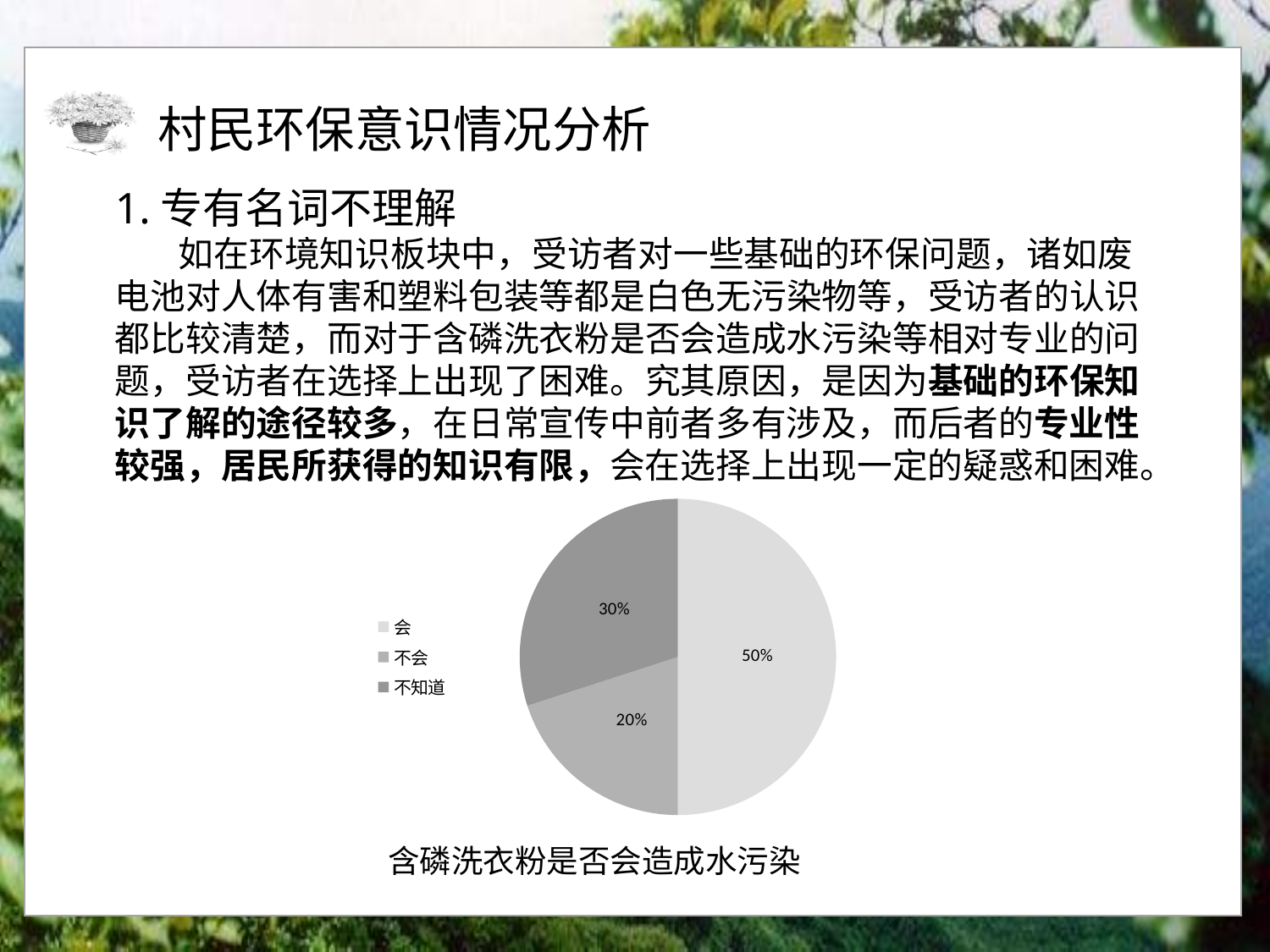
Which category has the smallest slice of the pie? 不会 How many slices does the pie chart have? 3 What share of the pie does 不会 take? 20% What kind of chart is shown on the slide? pie chart How many entries does the legend list? 3 What share of the pie does 会 take? 50% What is the caption shown below the pie chart? 含磷洗衣粉是否会造成水污染 What is the difference in percentage points between the 会 slice and the 不知道 slice? 20% What share of the pie does 不知道 take? 30% Which category has the largest slice of the pie? 会 What is the difference in percentage points between the 不知道 slice and the 不会 slice? 10% Which slice is larger, 不会 or 不知道? 不知道